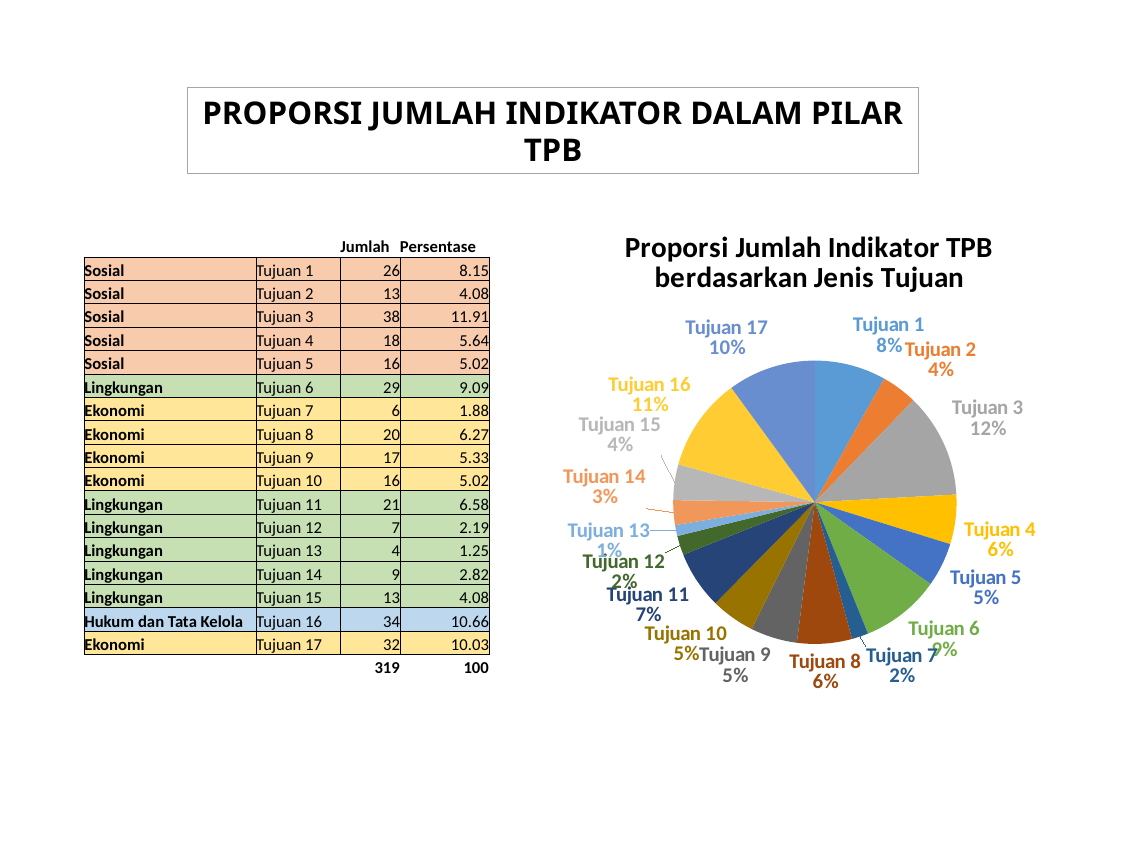
What is the difference in percentage points between Tujuan 3 and Tujuan 13 in the pie chart? 11 What percentage is shown for Tujuan 16 in the pie chart? 11% Which Tujuan has the largest share in the pie chart? Tujuan 3 What percentage is shown for Tujuan 6 in the pie chart? 9% What is the title of the pie chart? Proporsi Jumlah Indikator TPB berdasarkan Jenis Tujuan Which has a larger share in the pie chart, Tujuan 16 or Tujuan 17? Tujuan 16 Which Tujuan has the smallest share in the pie chart? Tujuan 13 How many slices does the pie chart have? 17 What share of the pie does Tujuan 3 represent? 12% What percentage is shown for Tujuan 13 in the pie chart? 1% What type of chart is shown on the slide? pie chart Which has a larger share in the pie chart, Tujuan 11 or Tujuan 7? Tujuan 11